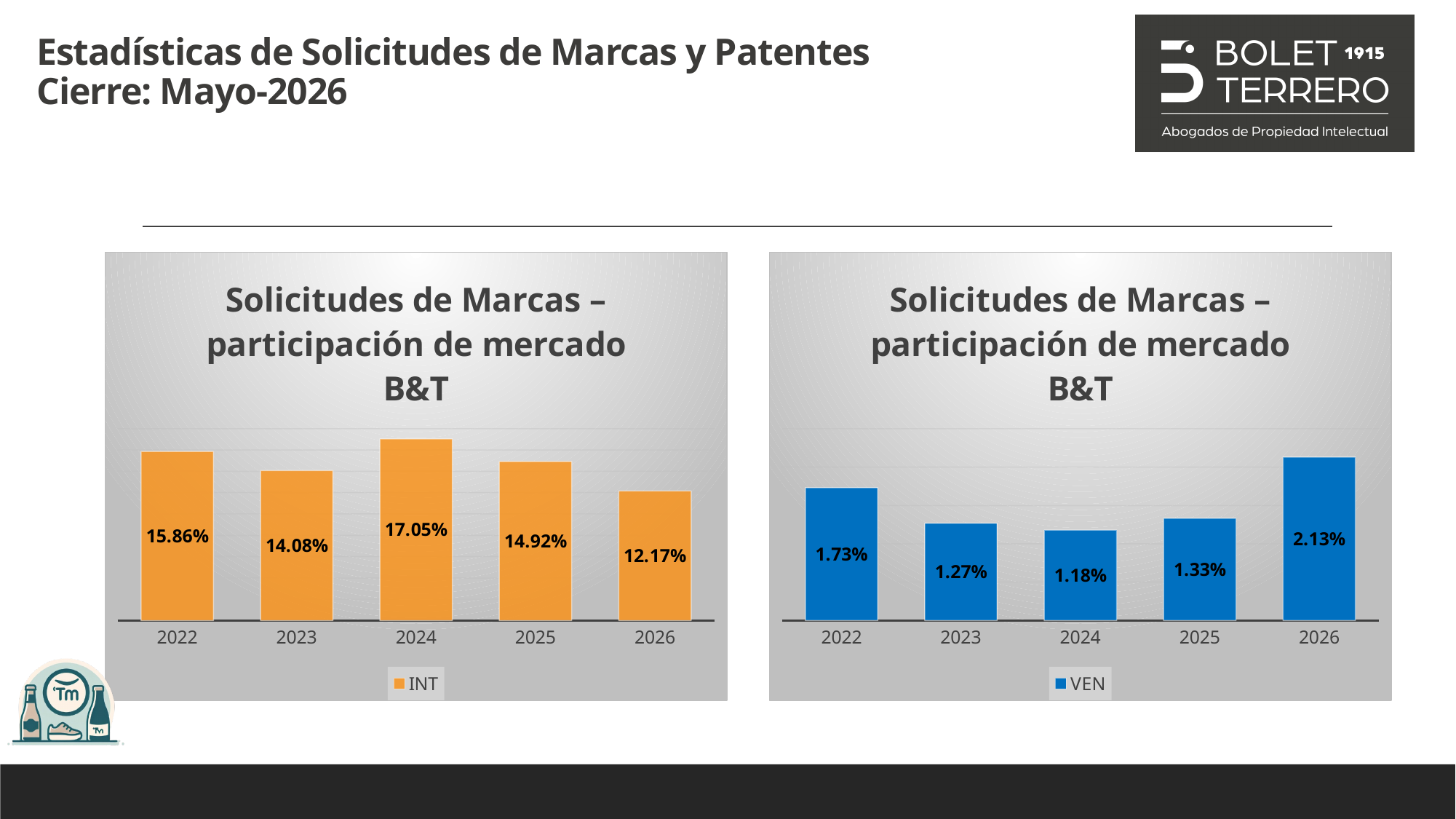
What kind of chart is the left chart (INT)? Bar chart In the right chart (VEN), do the values rise or fall from 2024 to 2026? Rise In the right chart (VEN), what is the difference between the 2026 and 2024 values? 0.95 percentage points What series name does the legend of the right chart show? VEN In the right chart (VEN), which year has the highest value? 2026 In the left chart (INT), which year has the lowest value? 2026 In the left chart (INT), which is larger, the value for 2022 or the value for 2023? 2022 In the right chart (VEN), what is the value for 2026? 2.13% In the left chart (INT), what is the value for 2024? 17.05% In the left chart (INT), what is the difference between the 2024 and 2026 values? 4.88 percentage points In the right chart (VEN), which year has the lowest value? 2024 How many years are shown on the x axis of the right chart (VEN)? 5